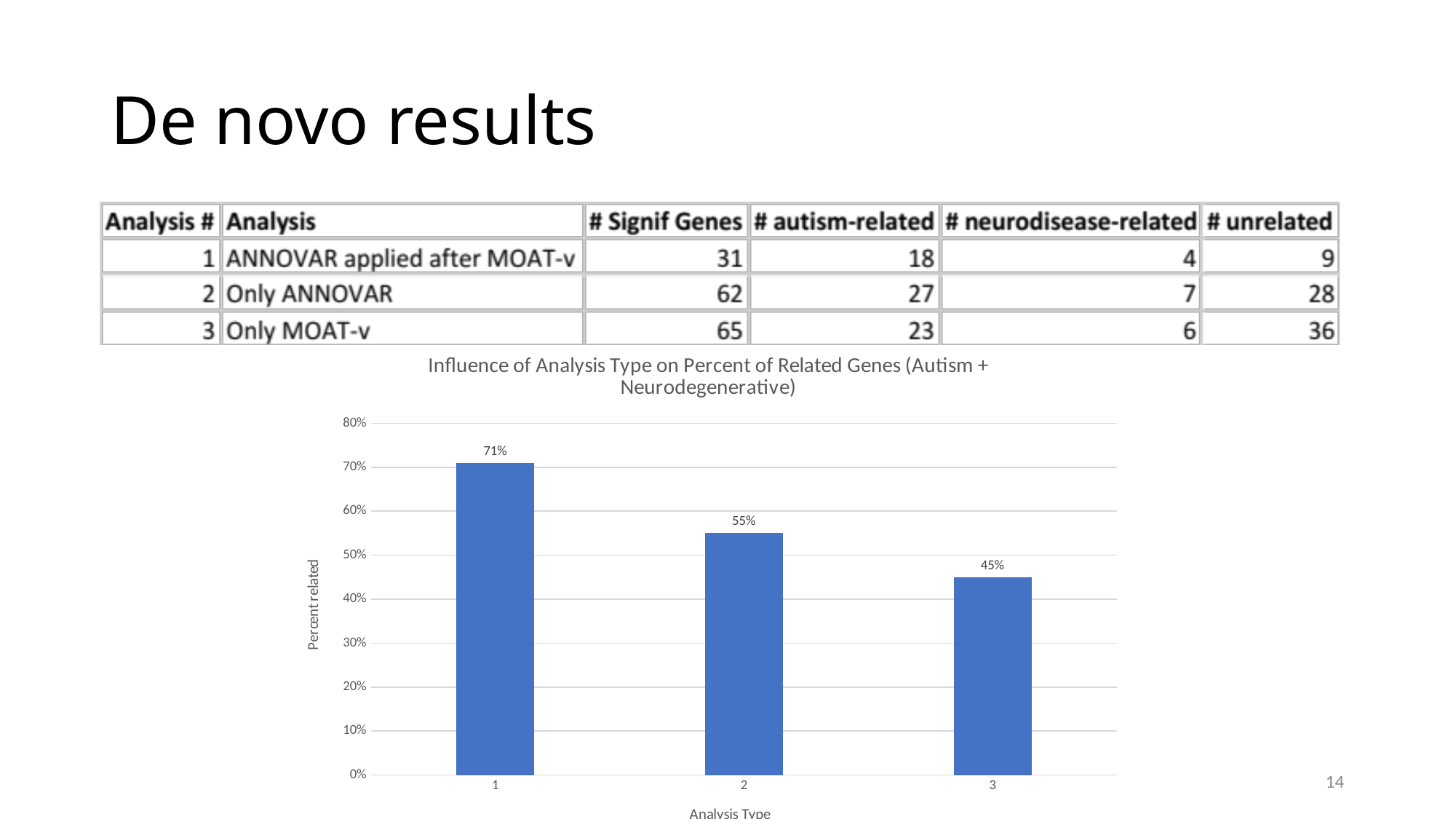
How many analysis types are shown in the chart? 3 What is the percent related for analysis type 3? 45% Which analysis type has the highest percent related? 1 Which analysis type has the lowest percent related? 3 What kind of chart is shown on the slide? bar chart What is the percent related for analysis type 2? 55% What is the difference in percent related between analysis type 1 and analysis type 3? 26% Is the value for analysis type 2 greater or less than 50%? greater What is the percent related for analysis type 1? 71% What is the difference in percent related between analysis type 2 and analysis type 3? 10% Which has a higher percent related, analysis type 2 or analysis type 3? 2 Do the values rise or fall from analysis type 1 to analysis type 3? fall